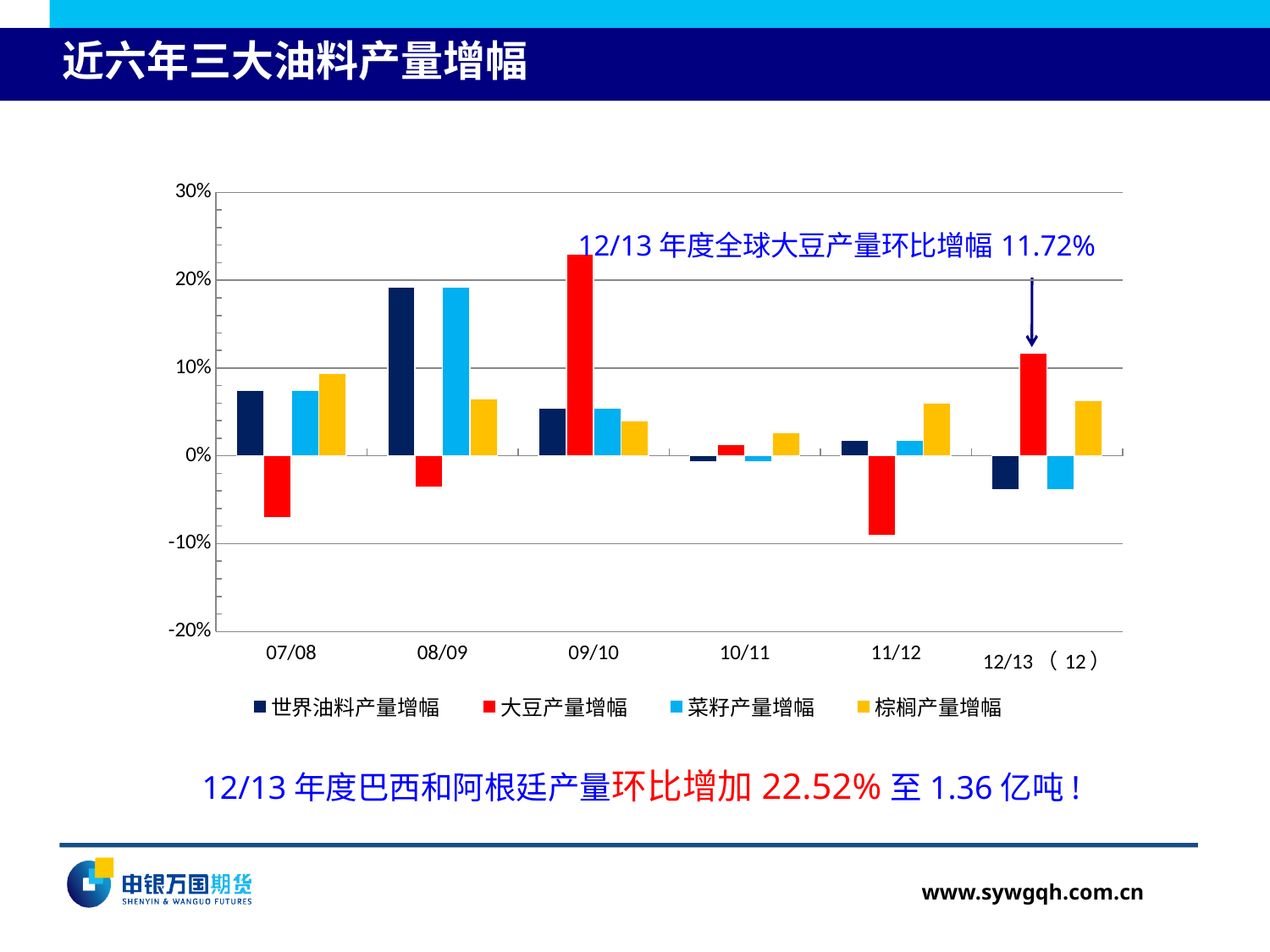
Is the 大豆产量增幅 value for 07/08 greater or less than -10%? greater What is the title of the slide containing the chart? 近六年三大油料产量增幅 In which year is the 大豆产量增幅 bar the lowest? 11/12 How many series does the chart legend list? 4 Is the 大豆产量增幅 value for 09/10 greater or less than 20%? greater In 07/08, which series has the highest bar? 棕榈产量增幅 In which year is the 大豆产量增幅 bar the highest? 09/10 In 08/09, which is larger: 世界油料产量增幅 or 大豆产量增幅? 世界油料产量增幅 Is the 世界油料产量增幅 value for 08/09 greater or less than 10%? greater How many year categories are shown on the x axis of the chart? 6 According to the annotation on the chart, what is the 大豆产量增幅 for 12/13? 11.72% What kind of chart is shown on the slide? bar chart